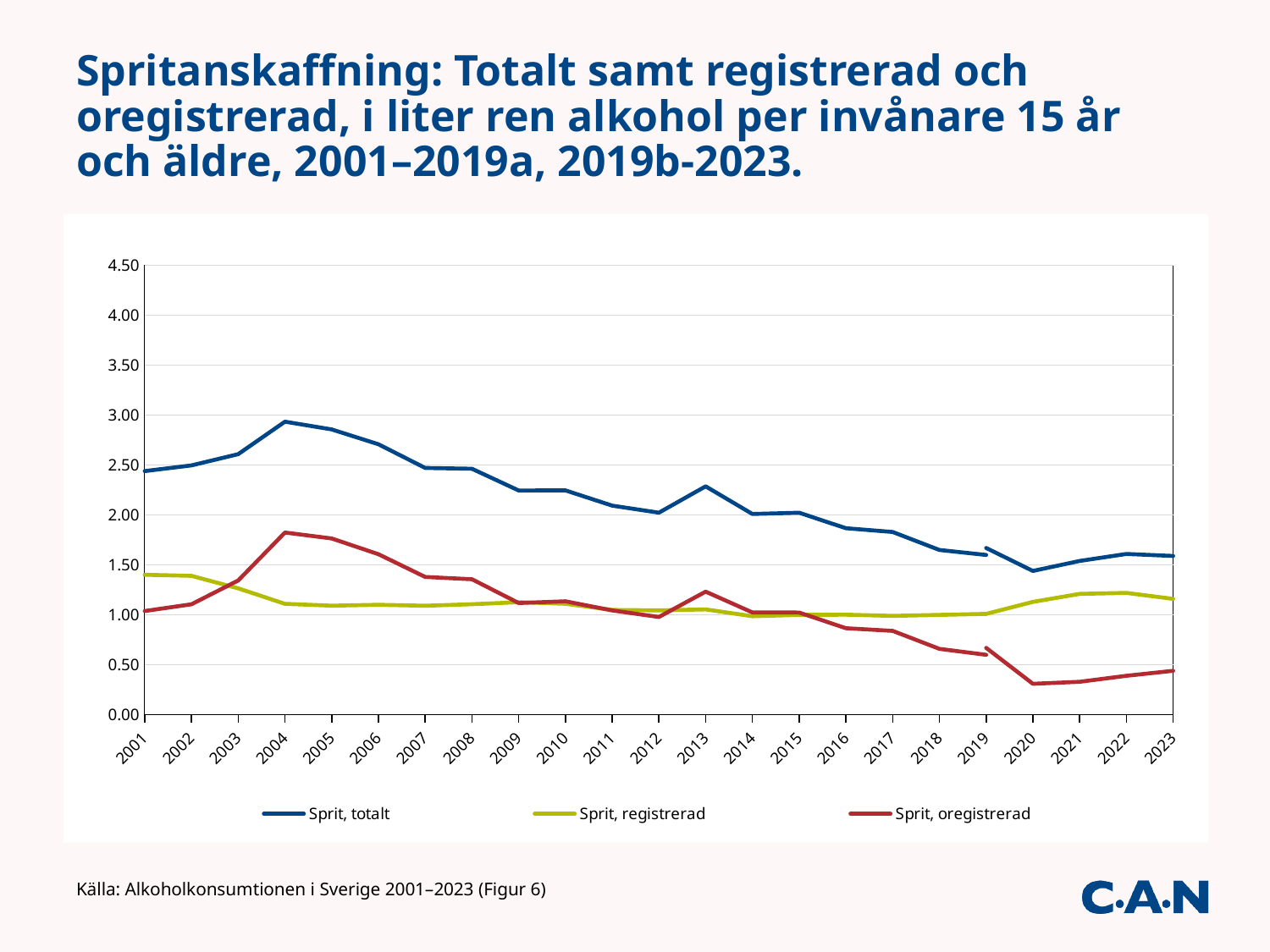
What kind of chart is shown on the slide? Line chart In which year does the 'Sprit, oregistrerad' line reach its highest value? 2004 Is the value for 'Sprit, totalt' in 2023 greater or less than 2.00? less Is the value for 'Sprit, oregistrerad' in 2020 greater or less than 0.50? less Does the 'Sprit, totalt' line generally rise or fall from 2004 to 2020? Fall Is the value for 'Sprit, totalt' in 2004 greater or less than 2.50? greater What are the three series named in the legend? Sprit, totalt; Sprit, registrerad; Sprit, oregistrerad How many series does the legend list? 3 In 2023, which is larger: 'Sprit, registrerad' or 'Sprit, oregistrerad'? Sprit, registrerad In which year is the 'Sprit, totalt' line at its lowest? 2020 How many years are shown on the x axis? 23 In which year does the 'Sprit, totalt' line reach its highest value? 2004